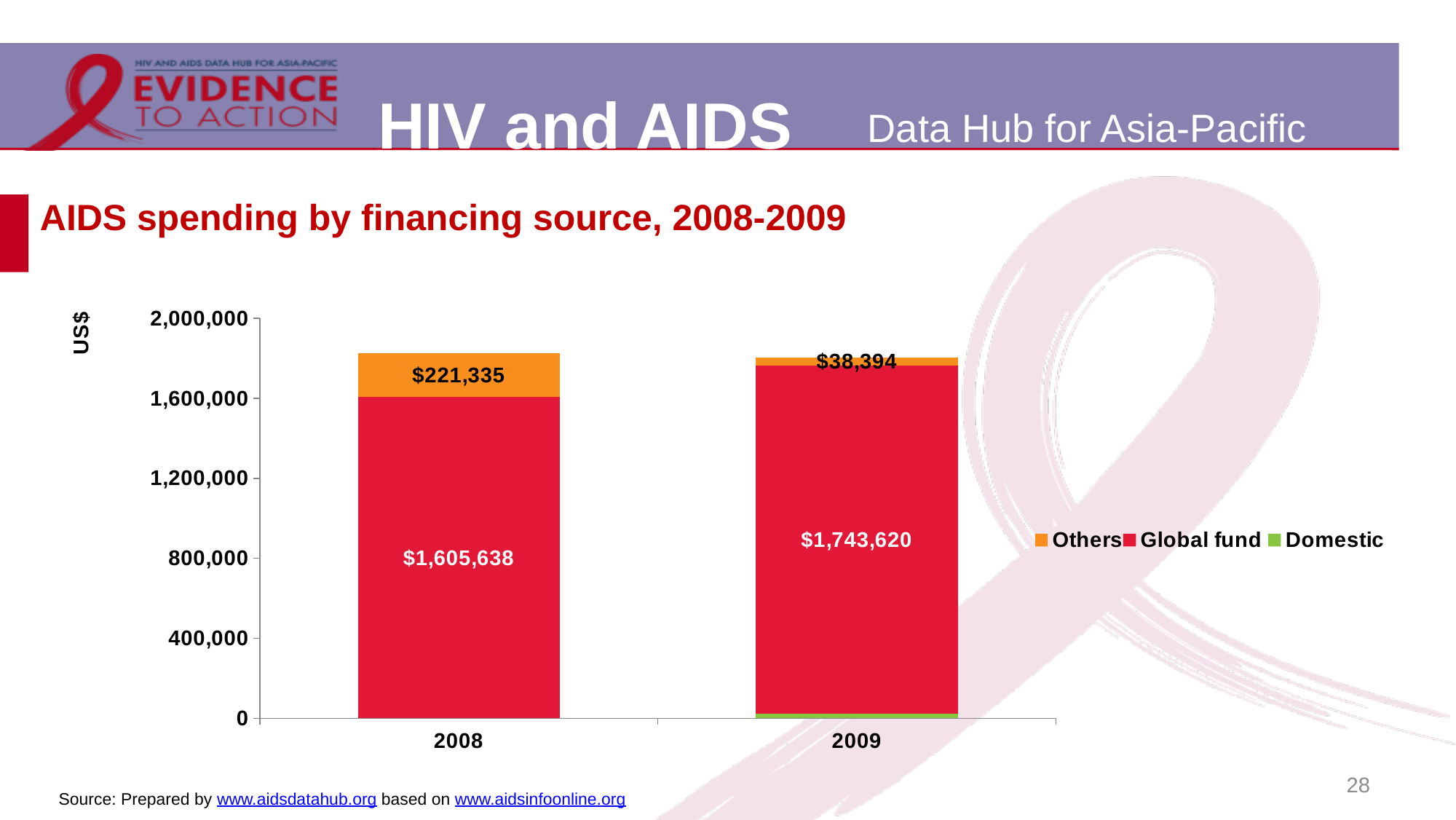
What is the Others spending for 2008? $221,335 What is the Others spending for 2009? $38,394 Which year has the higher Global fund spending? 2009 What is the Global fund spending for 2009? $1,743,620 Does Global fund spending rise or fall from 2008 to 2009? rise What kind of chart is shown on the slide? Stacked bar chart What is the difference between Others spending in 2008 and 2009? $182,941 Is the total height of the 2008 bar greater or less than 1,600,000? greater What is the Global fund spending for 2008? $1,605,638 How many series does the legend list? 3 What is the difference between Global fund spending in 2009 and 2008? $137,982 Which year has the higher Others spending? 2008